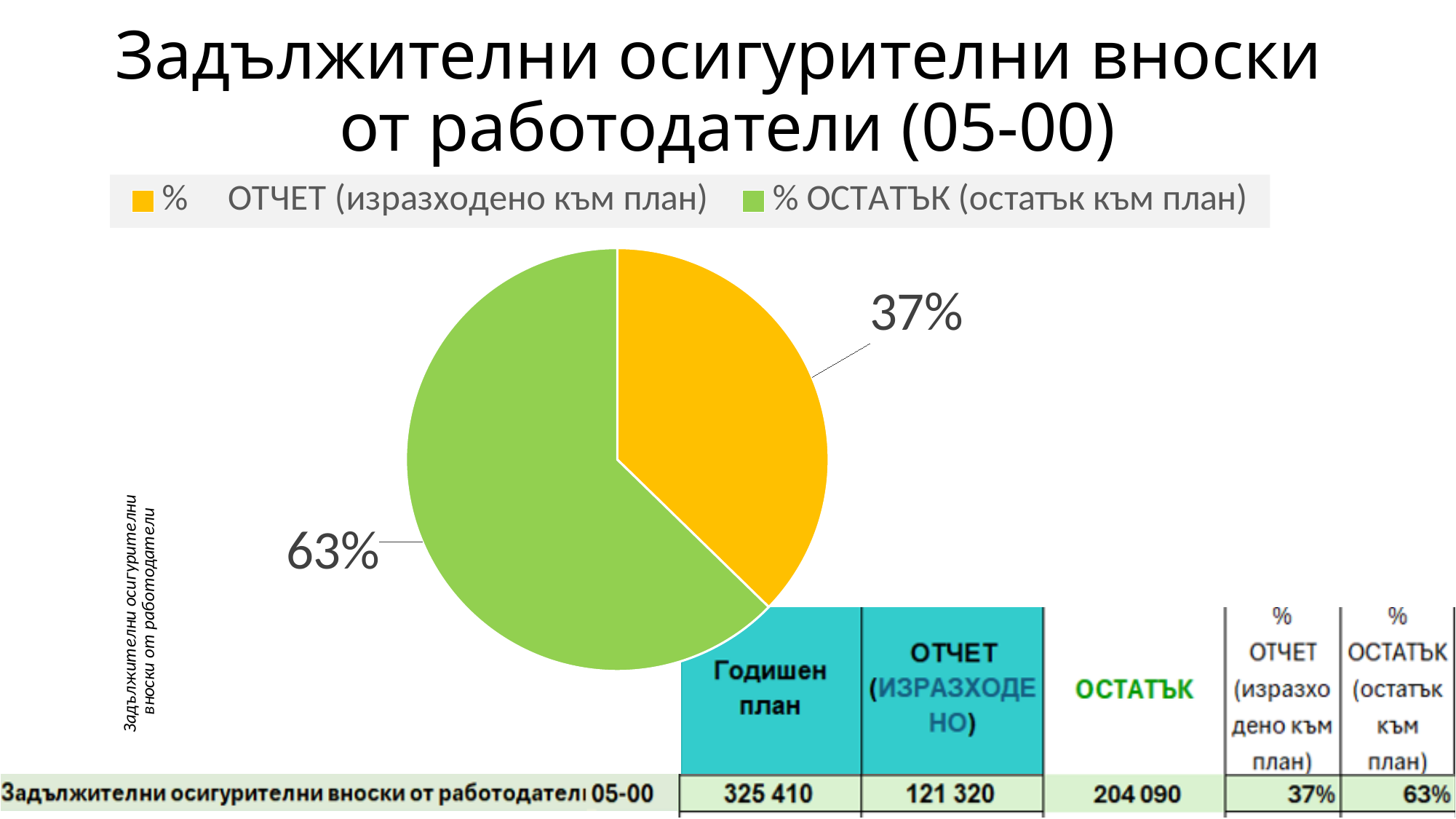
How many slices does the pie chart have? 2 What colour is the "% ОСТАТЪК (остатък към план)" slice? green What share of the pie does the "% ОСТАТЪК (остатък към план)" slice represent? 63% What is the difference in percentage points between the "% ОСТАТЪК" slice and the "% ОТЧЕТ" slice? 26 Which slice of the pie is the largest? % ОСТАТЪК (остатък към план) Is the share of the "% ОТЧЕТ" slice greater or less than 50%? less How many entries does the legend list? 2 Which is larger: the "% ОТЧЕТ" slice or the "% ОСТАТЪК" slice? % ОСТАТЪК What colour is the "% ОТЧЕТ (изразходено към план)" slice? yellow What kind of chart is shown on the slide? pie chart Which slice of the pie is the smallest? % ОТЧЕТ (изразходено към план) What share of the pie does the "% ОТЧЕТ (изразходено към план)" slice represent? 37%